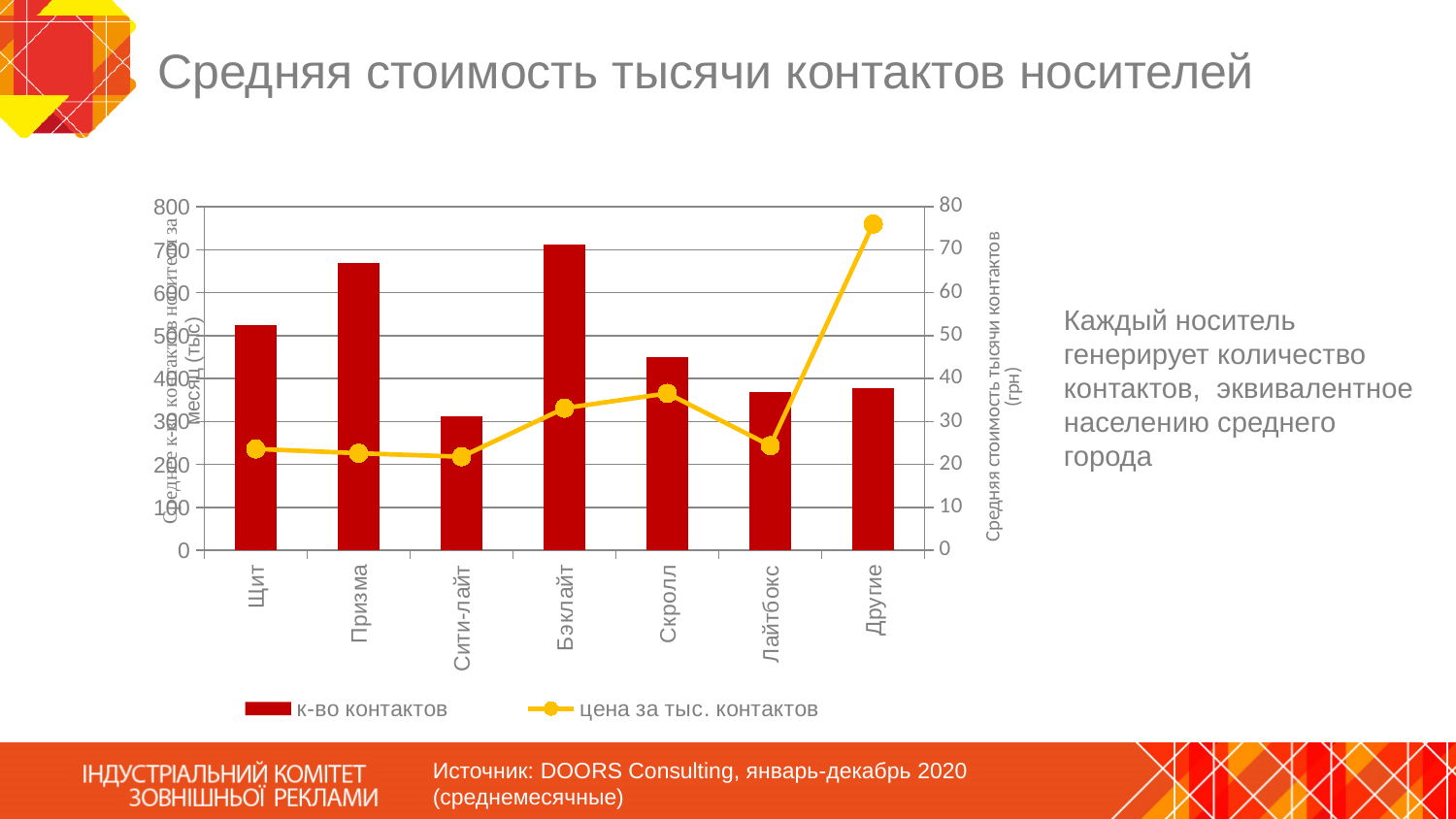
Which has the larger к-во контактов bar, Призма or Скролл? Призма Is the к-во контактов bar for Призма greater or less than 600? greater Which category has the shortest bar for к-во контактов? Сити-лайт Which category has the tallest bar for к-во контактов? Бэклайт Which category has the highest value on the цена за тыс. контактов line? Другие What kind of chart is shown on the slide? A combined bar and line chart Is the к-во контактов bar for Лайтбокс greater or less than 400? less How many series does the chart legend list? 2 What is the title of the chart on the slide? Средняя стоимость тысячи контактов носителей How many categories are shown on the x axis of the chart? 7 Which has the higher цена за тыс. контактов value, Скролл or Щит? Скролл Is the цена за тыс. контактов value for Другие greater or less than 70? greater